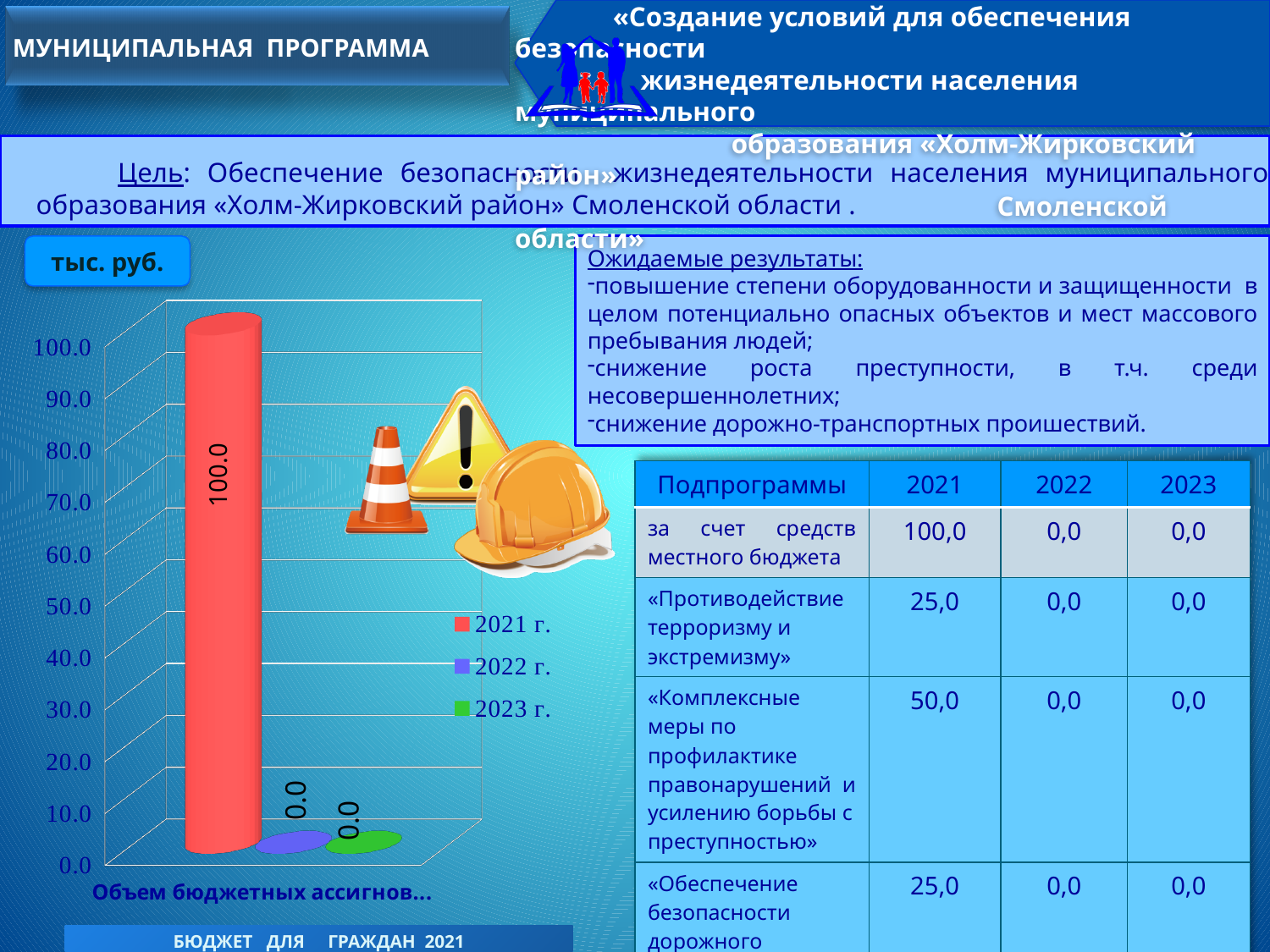
What is the value for the 2021 г. series in the bar chart? 100.0 What colour is the 2021 г. series in the bar chart? red Which is larger in the bar chart, the value for 2021 г. or the value for 2023 г.? 2021 г. How many series does the legend of the bar chart list? 3 Is the value for 2021 г. in the bar chart greater or less than 50.0? greater What is the value for the 2022 г. series in the bar chart? 0.0 What kind of chart is shown on the left of the slide? bar chart What is the value for the 2023 г. series in the bar chart? 0.0 What is the highest tick value shown on the vertical axis of the bar chart? 100.0 What is the difference between the 2021 г. value and the 2022 г. value in the bar chart? 100.0 What is the total of the 2021 г., 2022 г. and 2023 г. values in the bar chart? 100.0 Which series has the highest value in the bar chart? 2021 г.